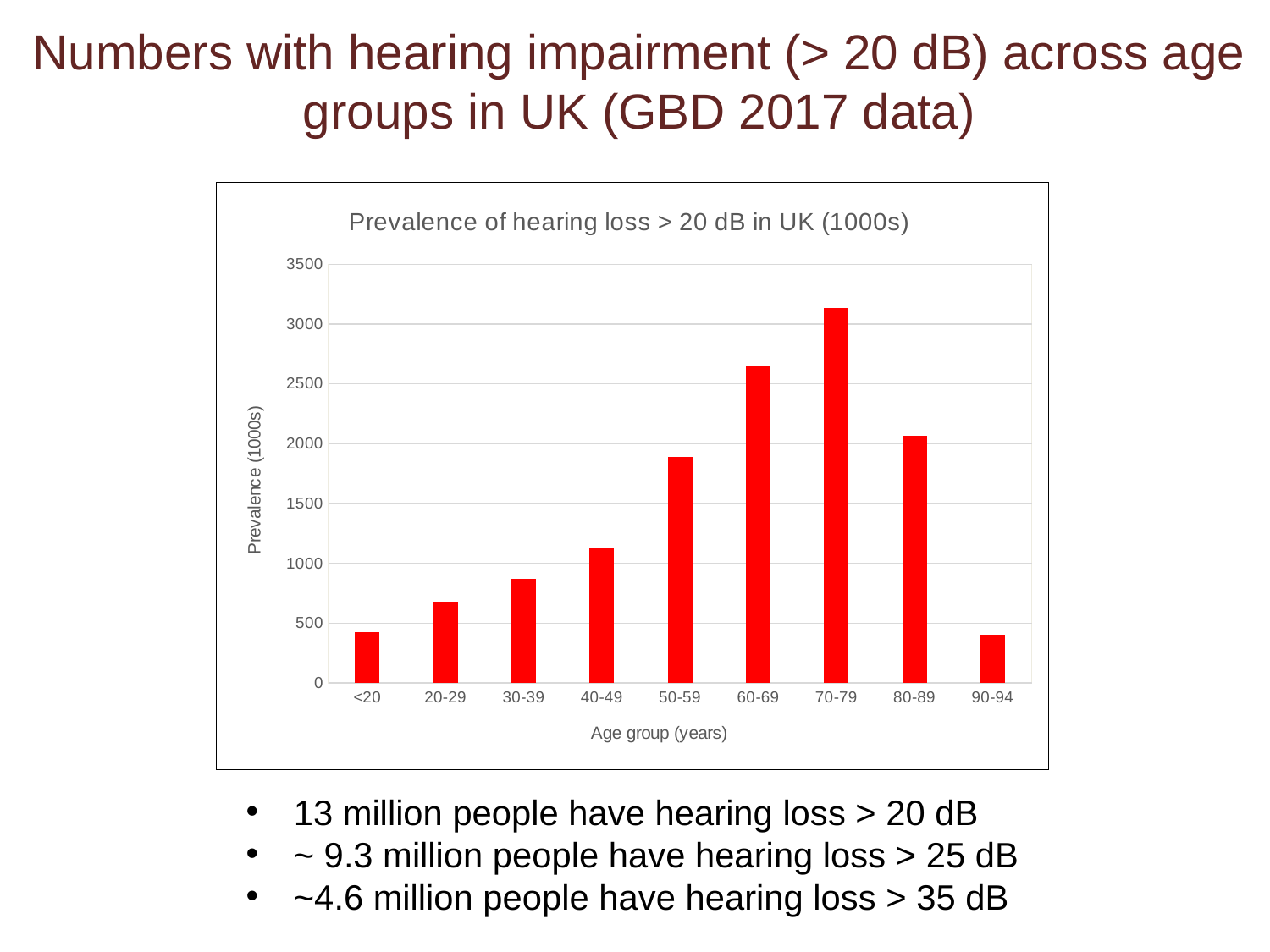
What is the title of the chart? Prevalence of hearing loss > 20 dB in UK (1000s) What kind of chart is shown on the slide? Bar chart Is the value for the 70-79 age group greater or less than 3000? greater Is the value for the 90-94 age group greater or less than 500? less Is the value for the 50-59 age group greater or less than 2000? less Do the values rise or fall from the <20 age group to the 70-79 age group? Rise Which age group has the highest prevalence of hearing loss > 20 dB? 70-79 Which has a higher prevalence, the 60-69 age group or the 80-89 age group? 60-69 How many age groups are plotted on the x axis? 9